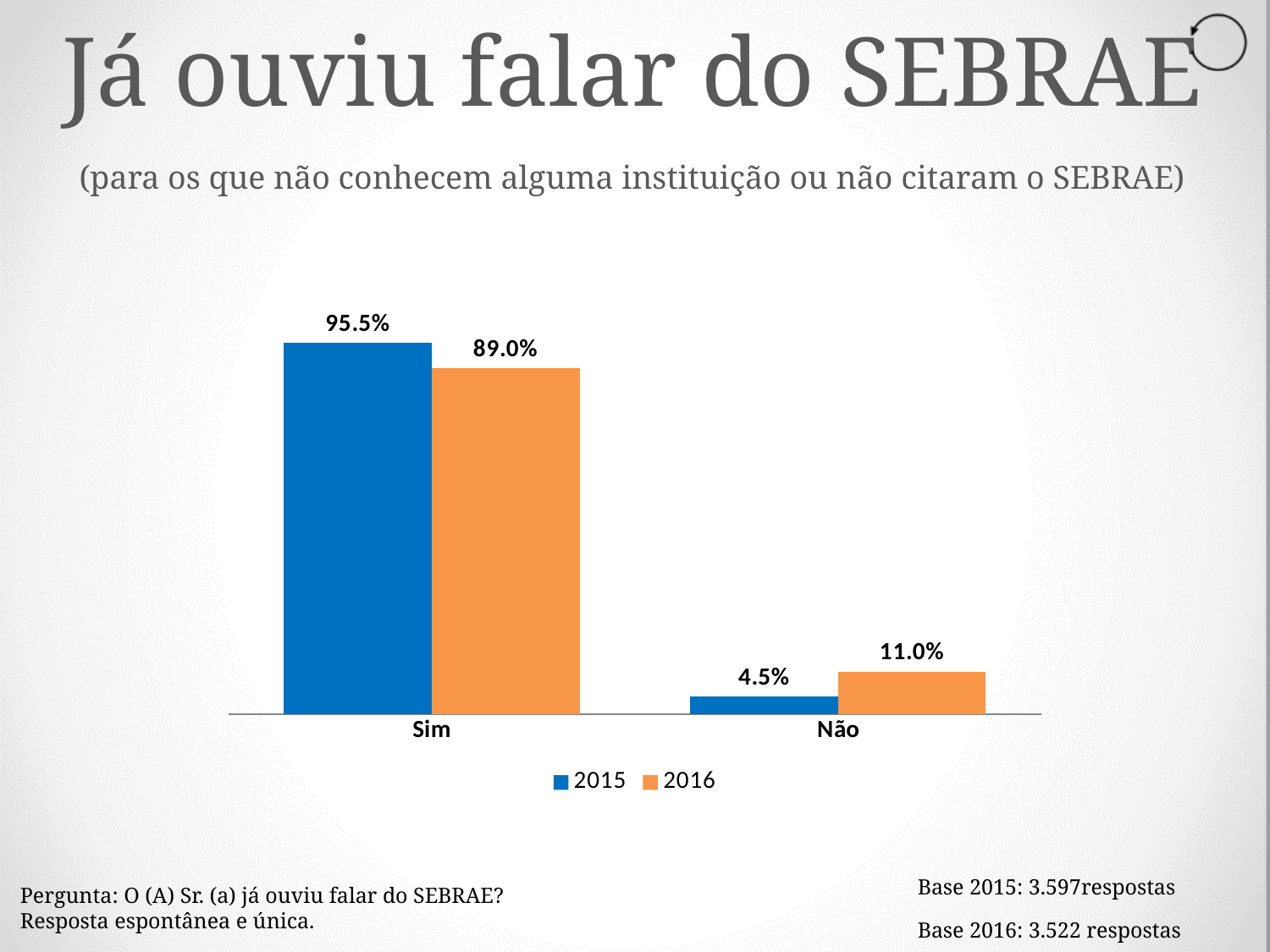
How many categories are shown on the x axis? 2 What is the value for "Sim" in the 2016 series? 89.0% What is the value for "Não" in the 2016 series? 11.0% What is the value for "Sim" in the 2015 series? 95.5% What is the difference between the 2016 and 2015 values for "Não"? 6.5% How many series does the legend list? 2 What is the value for "Não" in the 2015 series? 4.5% Which category has the highest value in the 2016 series? Sim What kind of chart is shown on the slide? Bar chart Which is larger for "Não": the 2015 value or the 2016 value? 2016 Which category has the lowest value in the 2015 series? Não What is the difference between the 2015 and 2016 values for "Sim"? 6.5%